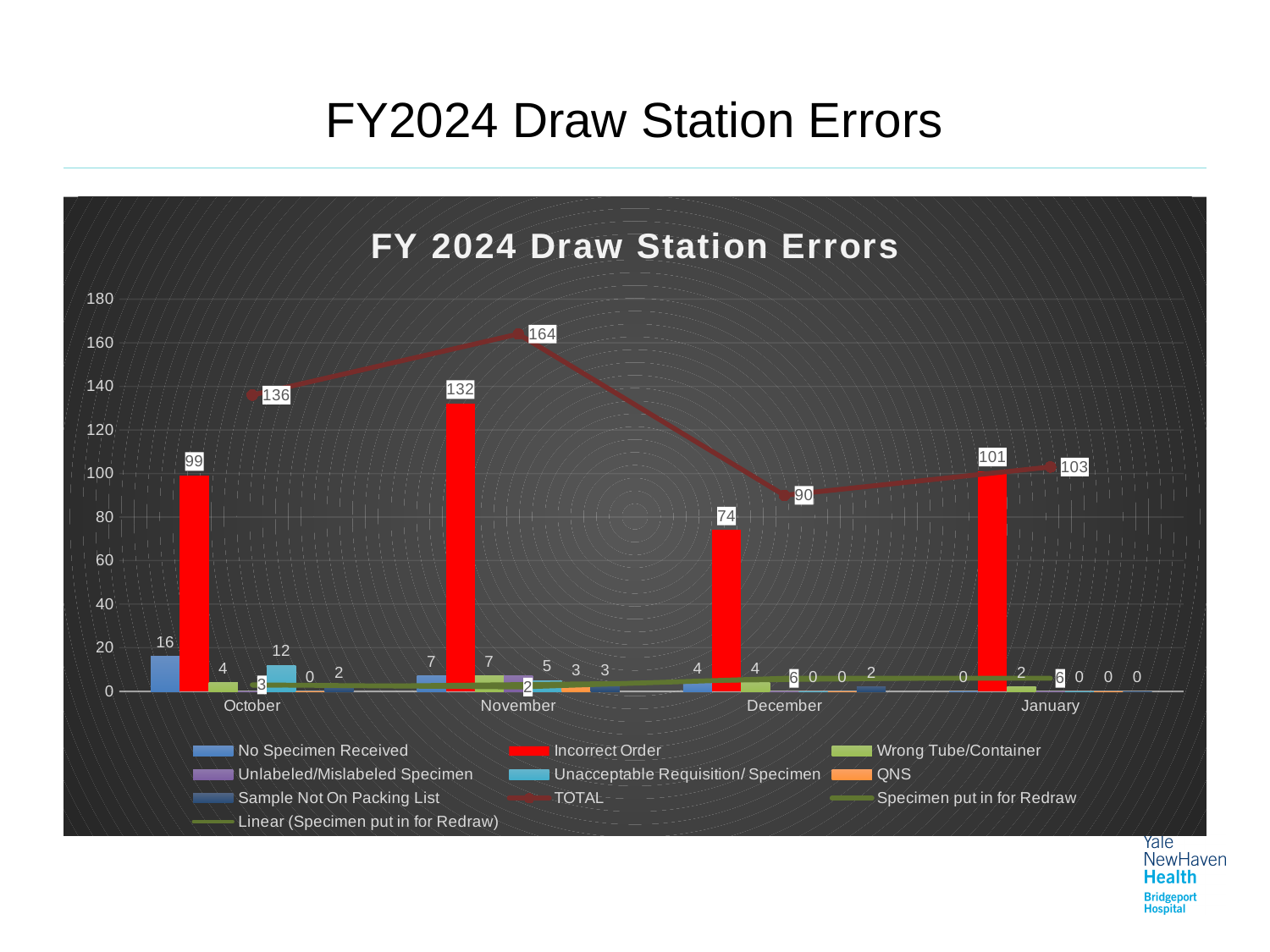
What is the TOTAL value for January? 103 Which month has the lowest TOTAL value? December Which month has the highest TOTAL value? November Which is larger, the Incorrect Order value for October or for January? January What is the TOTAL value for November? 164 What is the difference between the TOTAL values for November and December? 74 Is the TOTAL value for October greater or less than 120? greater What is the Incorrect Order value for December? 74 What kind of chart is this? Combined bar and line chart How many entries does the legend list? 10 How many months are shown on the x axis? 4 What is the No Specimen Received value for October? 16